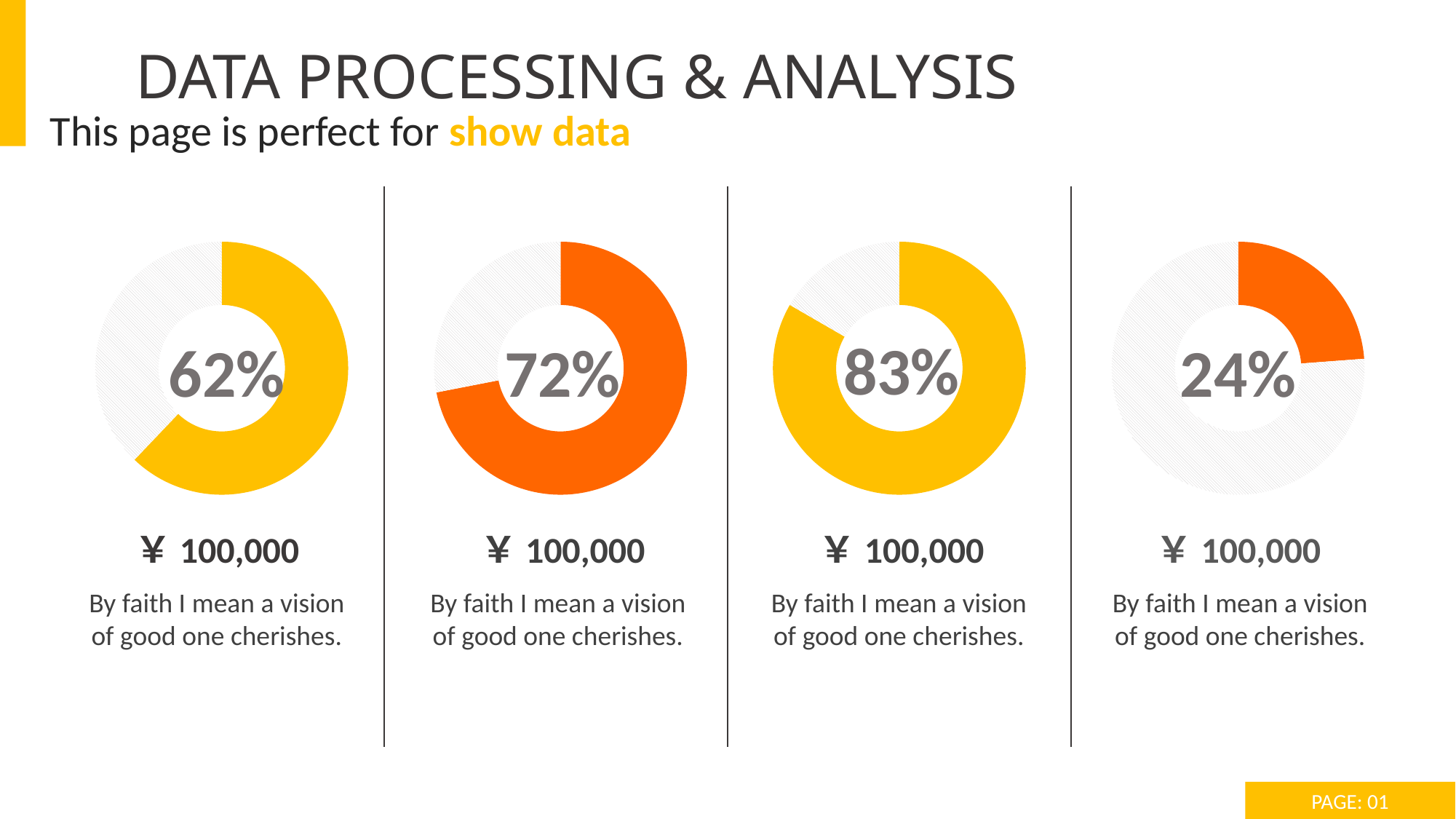
What percentage is shown in the centre of the second donut chart from the left? 72% What percentage is shown in the centre of the third donut chart from the left? 83% What kind of chart is used to display each percentage on the slide? Donut chart Which of the four donut charts shows the highest percentage? The third from the left (83%) Which is larger: the percentage in the leftmost donut chart or the percentage in the second donut chart from the left? The second from the left (72%) What is the difference between the percentage in the third donut chart and the percentage in the rightmost donut chart? 59% What percentage is shown in the centre of the rightmost donut chart? 24% Which of the four donut charts shows the lowest percentage? The rightmost (24%) What colour is the filled portion of the rightmost donut chart? Orange What percentage is shown in the centre of the leftmost donut chart? 62% What amount is printed below the second donut chart from the left? ¥ 100,000 How many donut charts are shown on the slide? 4